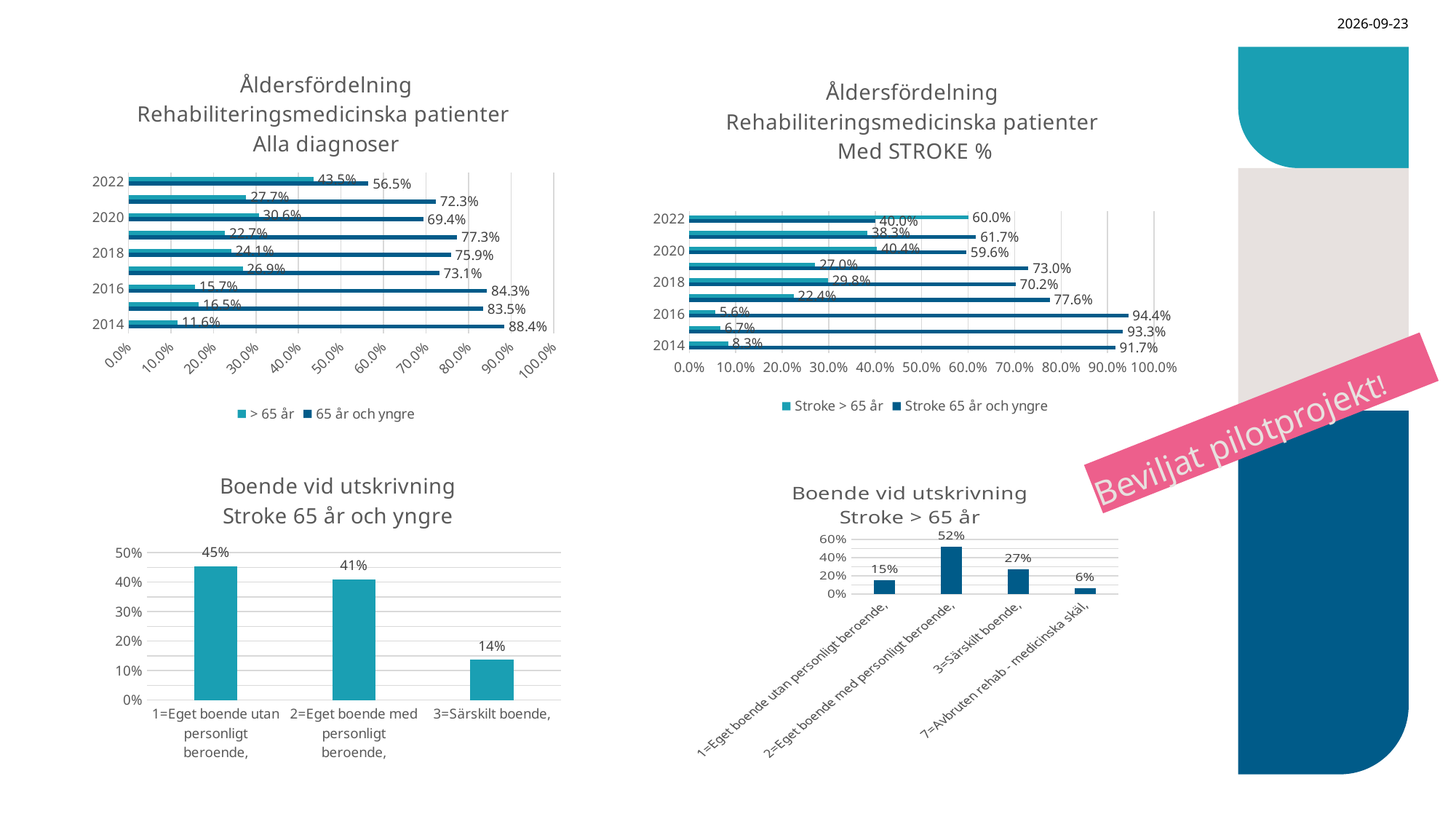
In the 'Alla diagnoser' age distribution chart (top left), what is the value for '> 65 år' in 2022? 43.5% In the 'Boende vid utskrivning Stroke 65 år och yngre' chart (bottom left), which category has the highest value? 1=Eget boende utan personligt beroende, In the 'Alla diagnoser' age distribution chart (top left), what is the value for '65 år och yngre' in 2014? 88.4% What kind of chart is the 'Boende vid utskrivning Stroke > 65 år' chart (bottom right)? Bar chart In the 'Alla diagnoser' age distribution chart (top left), what is the difference between the '65 år och yngre' and '> 65 år' values in 2022? 13.0% In the 'Boende vid utskrivning Stroke > 65 år' chart (bottom right), what is the value for '2=Eget boende med personligt beroende,'? 52% In the 'Boende vid utskrivning Stroke 65 år och yngre' chart (bottom left), how many categories are shown? 3 In the 'Med STROKE %' age distribution chart (top right), what is the value for 'Stroke > 65 år' in 2020? 40.4% In the 'Boende vid utskrivning Stroke > 65 år' chart (bottom right), which category has the lowest value? 7=Avbruten rehab - medicinska skäl, In the 'Boende vid utskrivning Stroke 65 år och yngre' chart (bottom left), what is the value for '3=Särskilt boende,'? 14% In the 'Med STROKE %' age distribution chart (top right), what is the value for 'Stroke 65 år och yngre' in 2016? 94.4% In the 'Med STROKE %' age distribution chart (top right), how many series does the legend list? 2